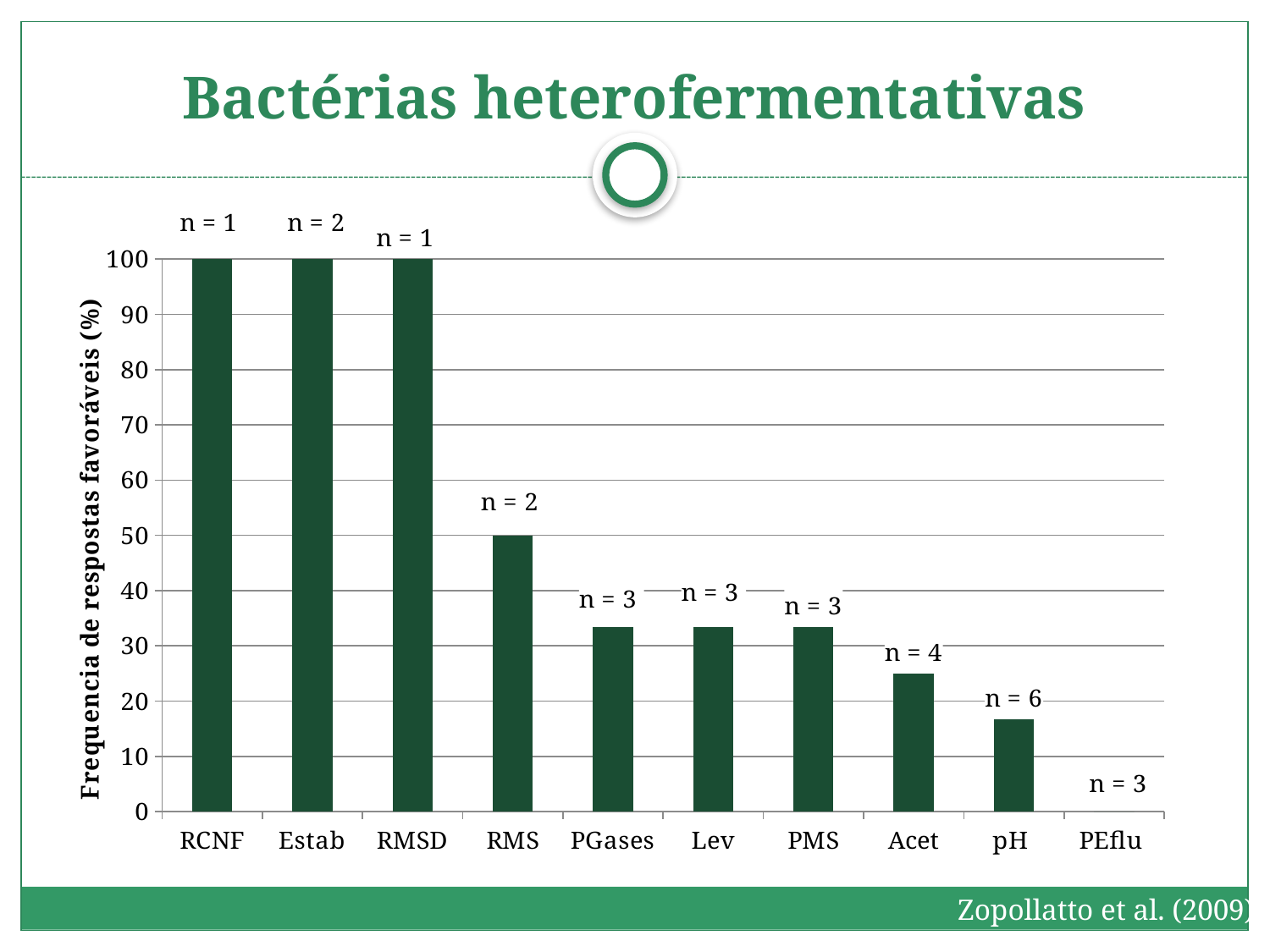
Is the value for Acet greater or less than 30? less Is the value for PGases greater or less than 30? greater What is the value for RCNF? 100 Do the values generally rise or fall moving from left to right along the x axis? fall Which category has the lowest value? PEflu How many categories are shown on the x axis of the chart? 10 What is the difference between the values for RCNF and RMS? 50 What label is printed above the pH bar? n = 6 What kind of chart is shown on the slide? bar chart What is the value for RMS? 50 Which has the larger value, RMS or Acet? RMS Is the value for pH greater or less than 20? less